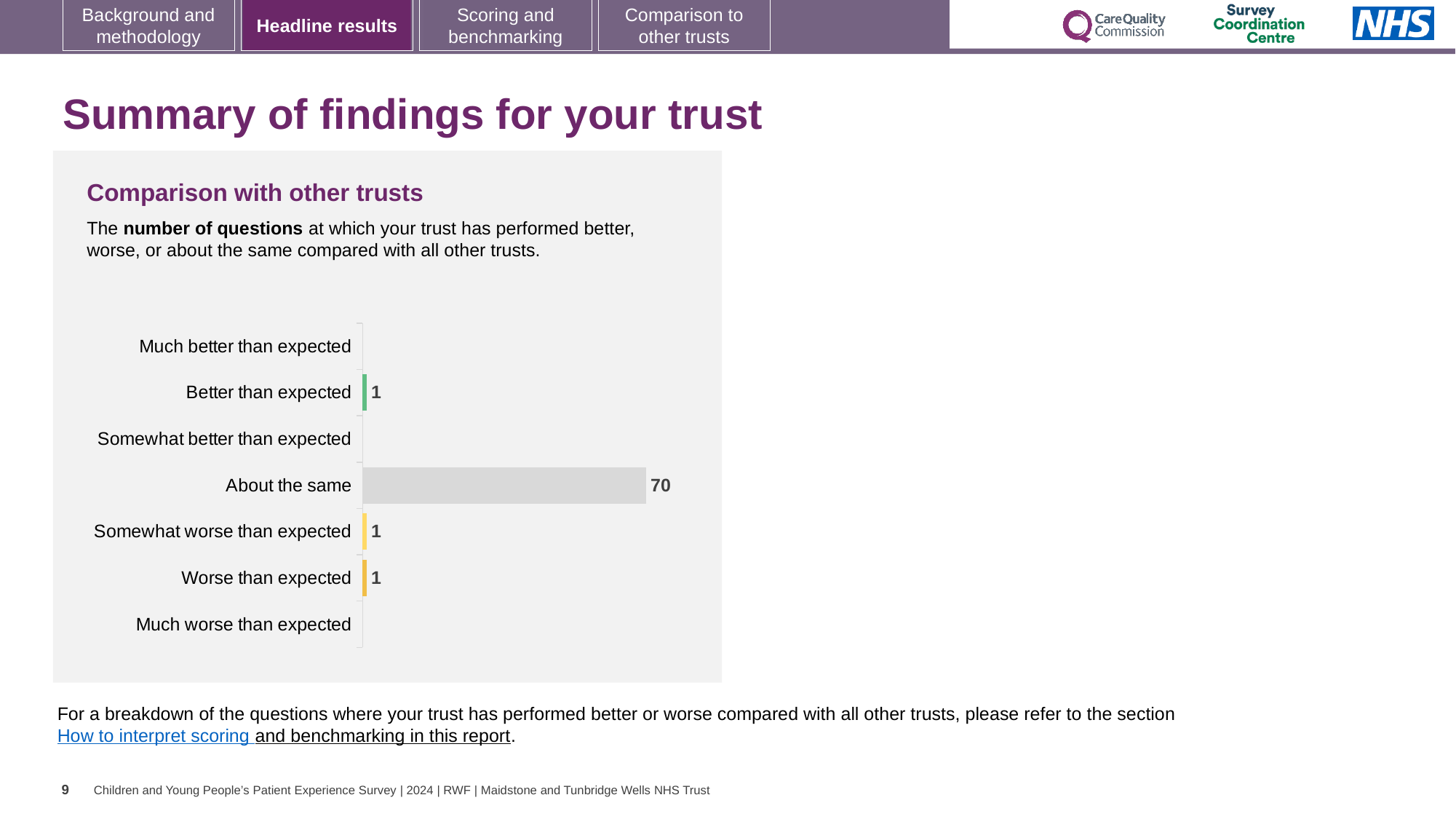
What kind of chart is shown under 'Comparison with other trusts'? bar chart How many questions were rated 'Better than expected'? 1 What colour is the bar for 'Better than expected'? green How many questions were rated 'Somewhat worse than expected'? 1 What is the difference between the number of questions rated 'About the same' and the number rated 'Better than expected'? 69 What is the total number of questions across all categories with a labelled bar? 73 How many categories are listed on the vertical axis of the chart? 7 How many questions were rated 'Worse than expected'? 1 What is the title of the chart? Comparison with other trusts Which category has the highest number of questions? About the same How many questions were rated 'About the same'? 70 Which is larger: the value for 'About the same' or the value for 'Worse than expected'? About the same